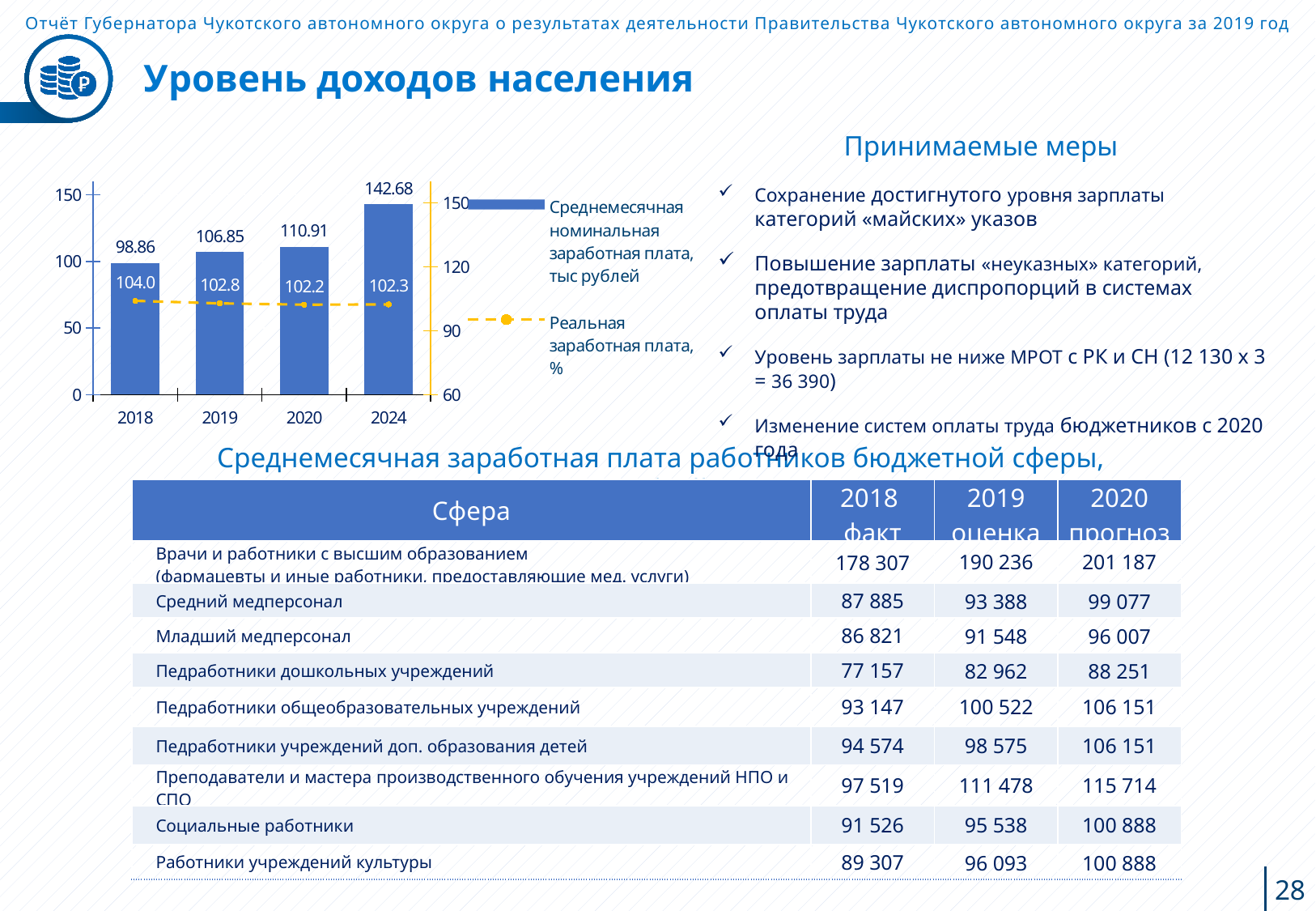
What is the average monthly nominal wage (Среднемесячная номинальная заработная плата) shown for 2024? 142.68 By how much does the nominal wage in 2024 exceed the nominal wage in 2020? 31.77 How many series does the chart legend list? 2 What is the value of the real wage (Реальная заработная плата, %) series for 2018? 104.0 How many years are shown on the x axis of the chart? 4 Which is larger: the nominal wage in 2019 or in 2020? 2020 What is the nominal wage value shown for 2019? 106.85 What is the difference between the real wage values for 2018 and 2019? 1.2 Which series in the chart is drawn as a dashed line with markers? Реальная заработная плата, % Which year has the highest nominal wage bar? 2024 Which year has the lowest nominal wage bar? 2018 Do the nominal wage bars rise or fall from 2018 to 2024? rise